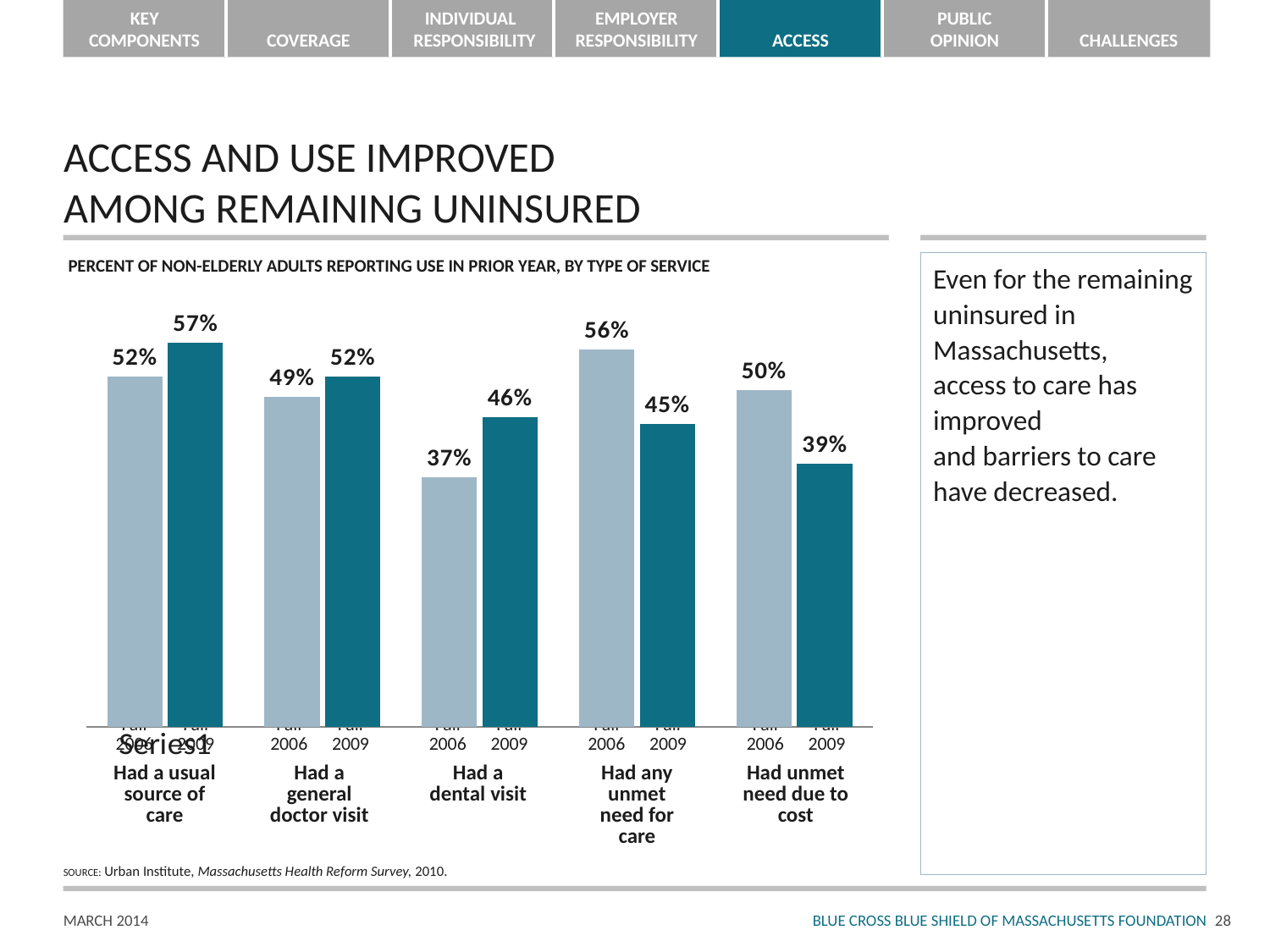
How many types of service are shown on the chart? 5 What is the difference between the Fall 2006 and Fall 2009 values for 'Had unmet need due to cost'? 11 percentage points Which category had the highest Fall 2006 value? Had any unmet need for care What was the value for 'Had a dental visit' in Fall 2006? 37% Which is larger: the Fall 2006 value for 'Had any unmet need for care' or the Fall 2009 value for 'Had a usual source of care'? Fall 2009 value for 'Had a usual source of care' (57%) What percent reported having any unmet need for care in Fall 2009? 45% By how many percentage points did 'Had a dental visit' change from Fall 2006 to Fall 2009? 9 percentage points What was the Fall 2006 value for 'Had unmet need due to cost'? 50% Which category had the lowest Fall 2009 value? Had unmet need due to cost Did the value for 'Had a general doctor visit' rise or fall from Fall 2006 to Fall 2009? Rise What percent of non-elderly uninsured adults reported having a usual source of care in Fall 2009? 57% What kind of chart is shown on the slide? Bar chart